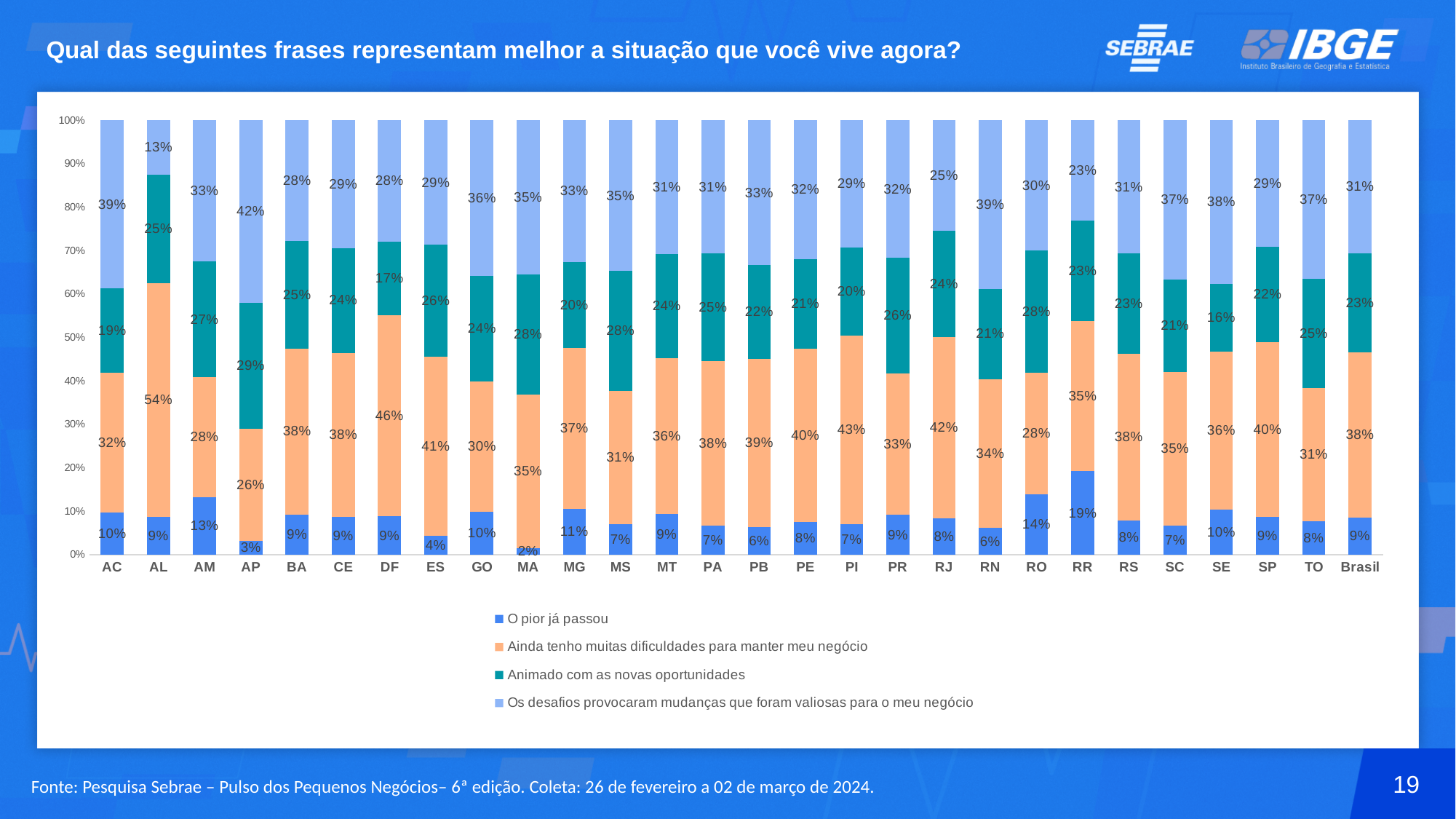
What is the value for 'Animado com as novas oportunidades' for DF? 17% Which category has the lowest value for 'Os desafios provocaram mudanças que foram valiosas para o meu negócio'? AL How many series does the legend list? 4 Which is larger for AP: 'Animado com as novas oportunidades' or 'Ainda tenho muitas dificuldades para manter meu negócio'? Animado com as novas oportunidades Which category has the lowest value for 'O pior já passou'? MA What is the value for 'O pior já passou' for RR? 19% What is the difference between the 'Ainda tenho muitas dificuldades para manter meu negócio' values for AL and AC? 22% What is the value for 'Os desafios provocaram mudanças que foram valiosas para o meu negócio' for Brasil? 31% What is the value for 'Ainda tenho muitas dificuldades para manter meu negócio' for AL? 54% How many categories are shown on the x axis? 28 What kind of chart is shown on the slide? Stacked bar chart Which category has the highest value for 'O pior já passou'? RR